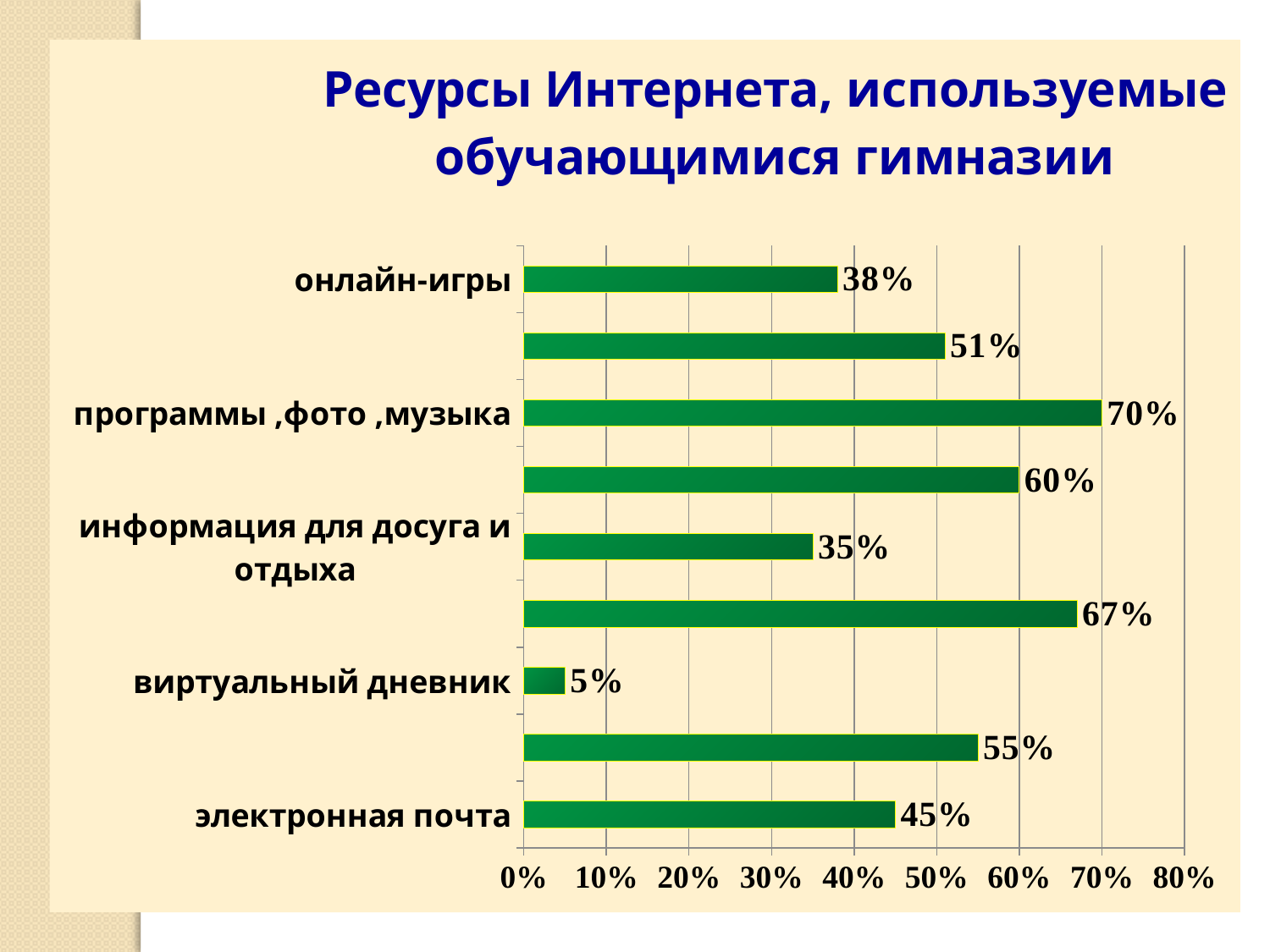
How many bars are plotted in the chart? 9 What is the value for онлайн-игры? 38% What is the value for программы, фото, музыка? 70% What is the value for виртуальный дневник? 5% Which category has the highest value? программы, фото, музыка Is the value for информация для досуга и отдыха greater or less than 40%? less Which category has the lowest value? виртуальный дневник What is the value for электронная почта? 45% Which is larger, the value for онлайн-игры or the value for электронная почта? электронная почта What is the difference between the values for программы, фото, музыка and электронная почта? 25% What is the value for информация для досуга и отдыха? 35% What kind of chart is shown on the slide? bar chart